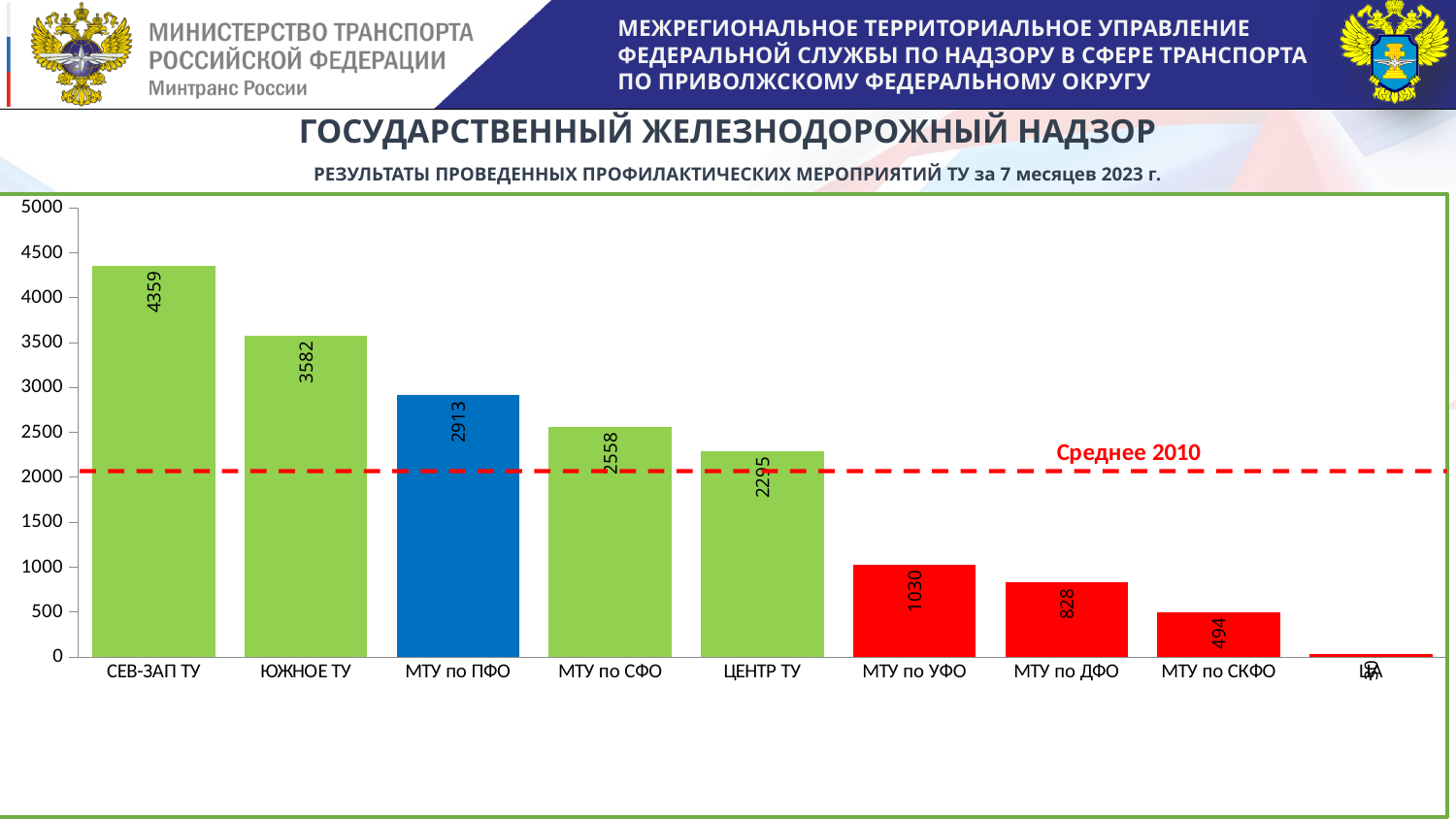
What is the value for МТУ по ПФО? 2913 Which is larger, the value for МТУ по УФО or the value for МТУ по ДФО? МТУ по УФО What kind of chart is shown on the slide? bar chart What is the difference between the values for ЮЖНОЕ ТУ and МТУ по СФО? 1024 What is the value for СЕВ-ЗАП ТУ? 4359 What value does the red dashed line labelled 'Среднее' represent? 2010 What is the value for МТУ по СКФО? 494 Is the value for МТУ по ДФО greater or less than 1000? less Which bar is coloured blue? МТУ по ПФО How many bars are plotted in the chart? 9 Which category has the highest value? СЕВ-ЗАП ТУ Is the value for ЦЕНТР ТУ greater or less than 2000? greater